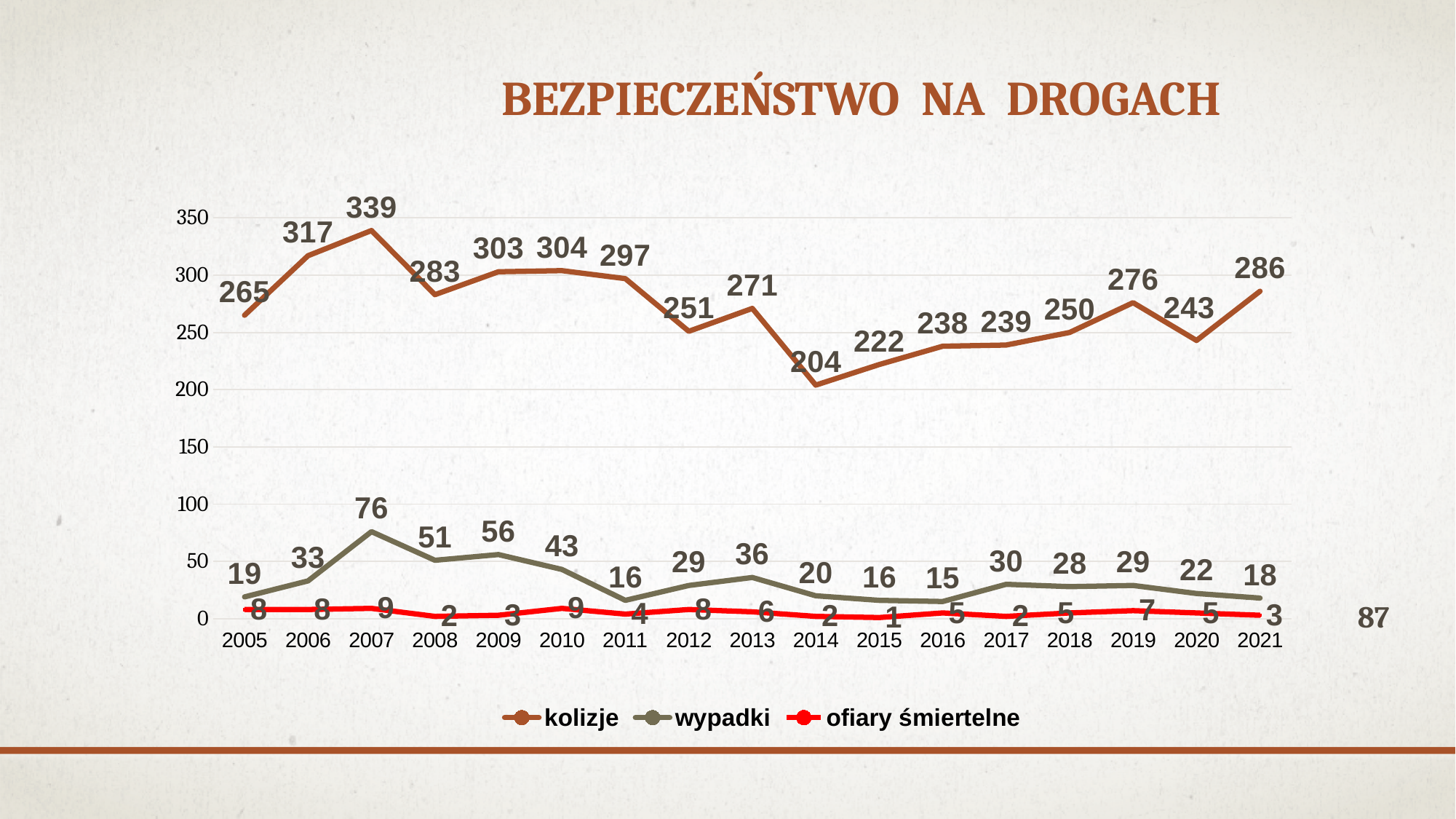
What is the difference between kolizje in 2021 and kolizje in 2020? 43 In which year is the wypadki series at its highest? 2007 What is the value of kolizje in 2007? 339 What is the title of the chart? BEZPIECZEŃSTWO NA DROGACH What is the value of wypadki in 2009? 56 Is the value of kolizje in 2014 greater or less than 250? less What is the value of ofiary śmiertelne in 2015? 1 What kind of chart is shown on the slide? line chart In which year is the kolizje series at its lowest? 2014 Which is larger: wypadki in 2008 or wypadki in 2010? wypadki in 2008 How many series does the legend list? 3 How many years are shown on the x axis? 17